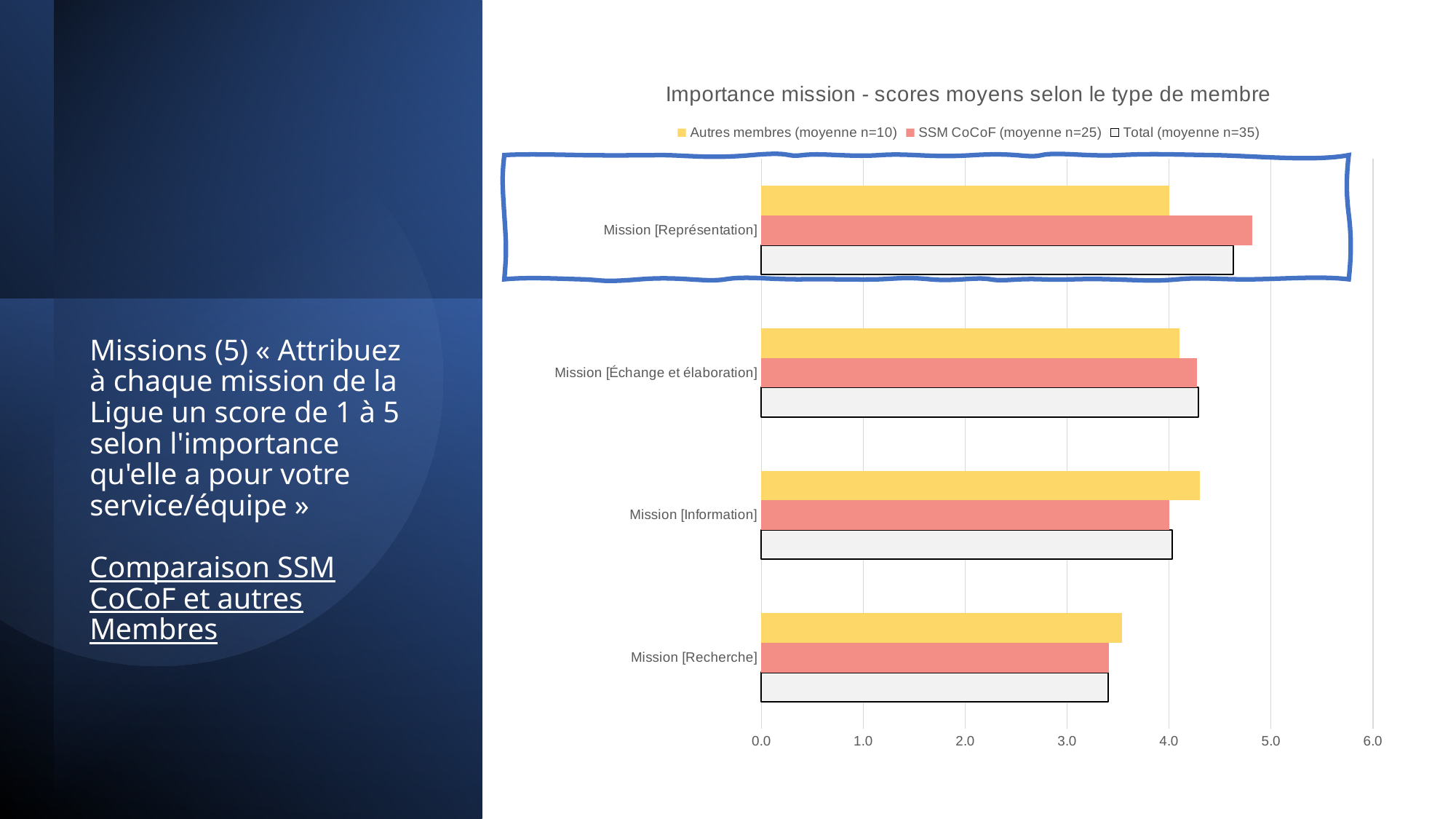
Is the Autres membres value for Mission [Information] greater or less than 4.0? greater What kind of chart is shown on the slide? bar chart For the SSM CoCoF series, which mission has the lowest score? Mission [Recherche] For Mission [Représentation], which is larger: the SSM CoCoF value or the Autres membres value? SSM CoCoF Is the SSM CoCoF value for Mission [Représentation] greater or less than 4.0? greater How many series does the chart legend list? 3 For the SSM CoCoF series, which mission has the highest score? Mission [Représentation] How many mission categories are plotted in the chart? 4 What is the title of the chart? Importance mission - scores moyens selon le type de membre Is the Autres membres value for Mission [Recherche] greater or less than 4.0? less Which mission category is highlighted with a drawn box on the chart? Mission [Représentation]